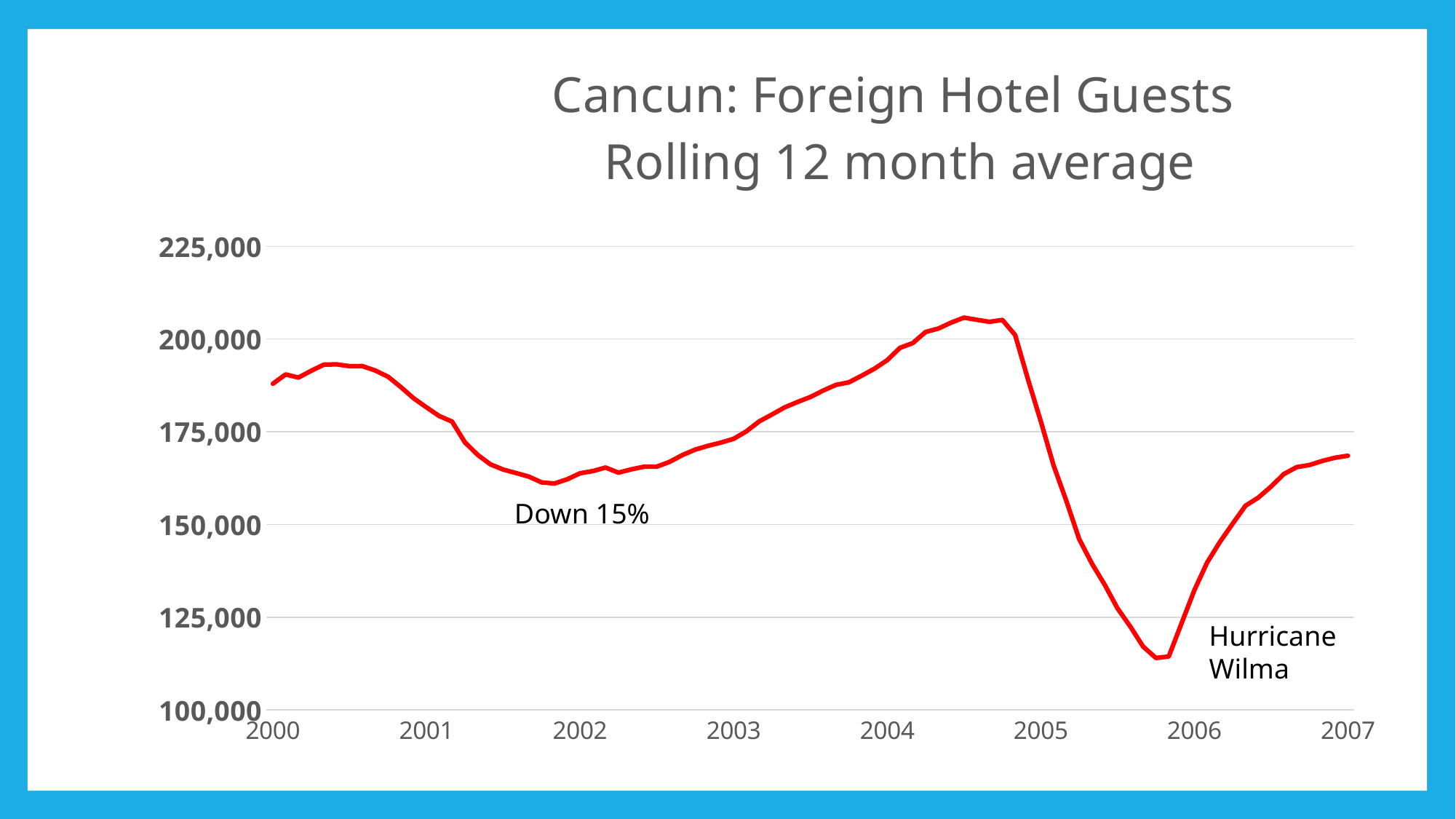
Is the value at the start of 2002 greater or less than 175,000? less Does the line rise or fall between the start of 2005 and the end of 2005? fall What is the title of the chart? Cancun: Foreign Hotel Guests Rolling 12 month average Does the line rise or fall between the start of 2002 and the start of 2004? rise Which is larger, the value at the start of 2000 or the value at 2007? 2000 What kind of chart is shown on the slide? line chart What event is labelled next to the sharp drop in the line near the end of 2005? Hurricane Wilma Is the value at 2007 greater or less than 175,000? less Is the value at the start of 2004 greater or less than 175,000? greater